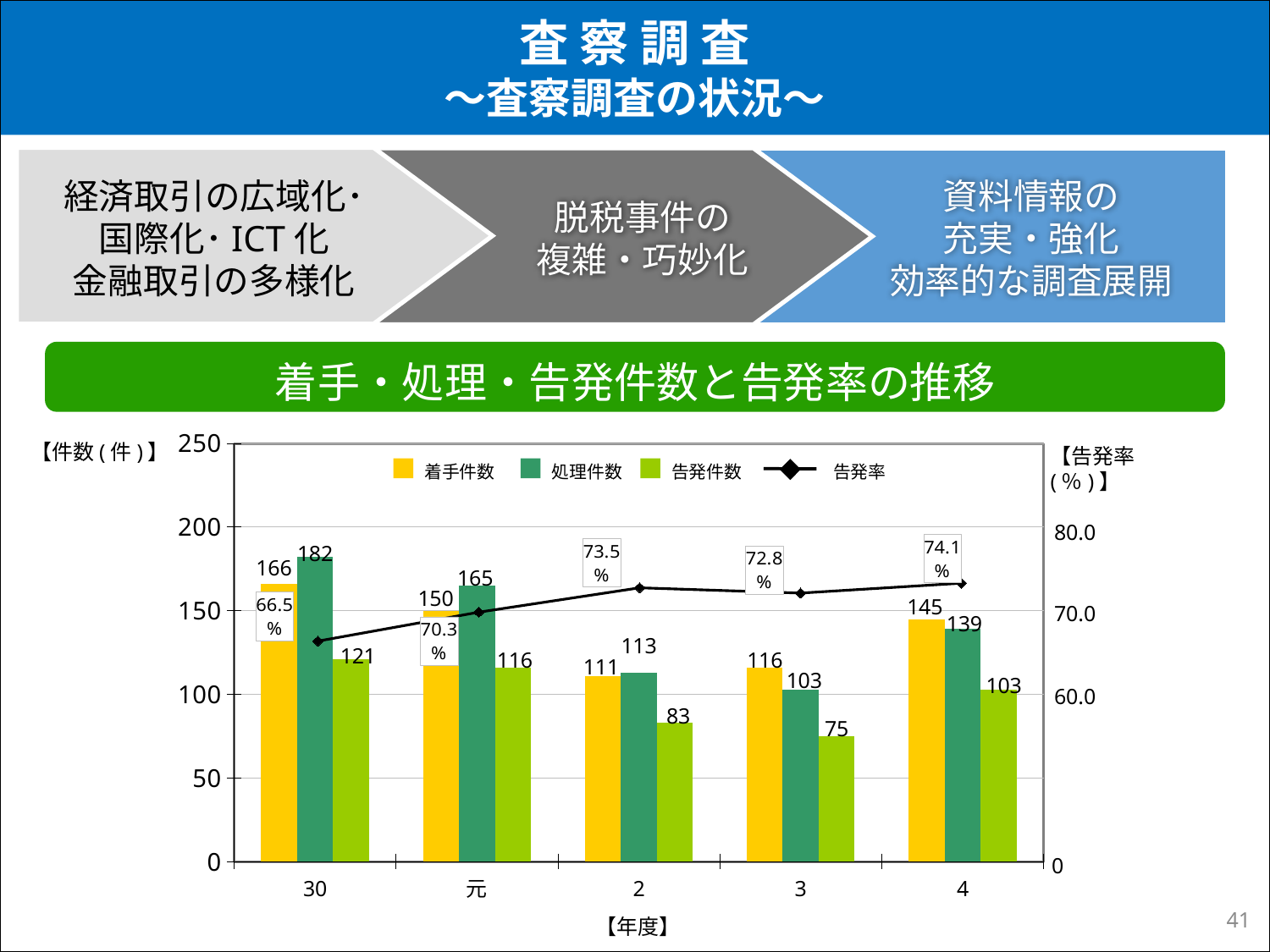
How many series does the legend list? 4 What is the title of the chart? 着手・処理・告発件数と告発率の推移 What is the 処理件数 value for fiscal year 元? 165 Which fiscal year has the highest 処理件数? 30 What is the 告発件数 value for fiscal year 2? 83 How many fiscal years are shown on the x axis? 5 What is the 告発率 for fiscal year 4? 74.1% For fiscal year 3, which is larger: 着手件数 or 処理件数? 着手件数 Does the 告発率 line rise or fall from fiscal year 30 to fiscal year 2? rise What is the difference between the 着手件数 and 告発件数 for fiscal year 4? 42 Which fiscal year has the lowest 告発件数? 3 What is the 着手件数 value for fiscal year 30? 166